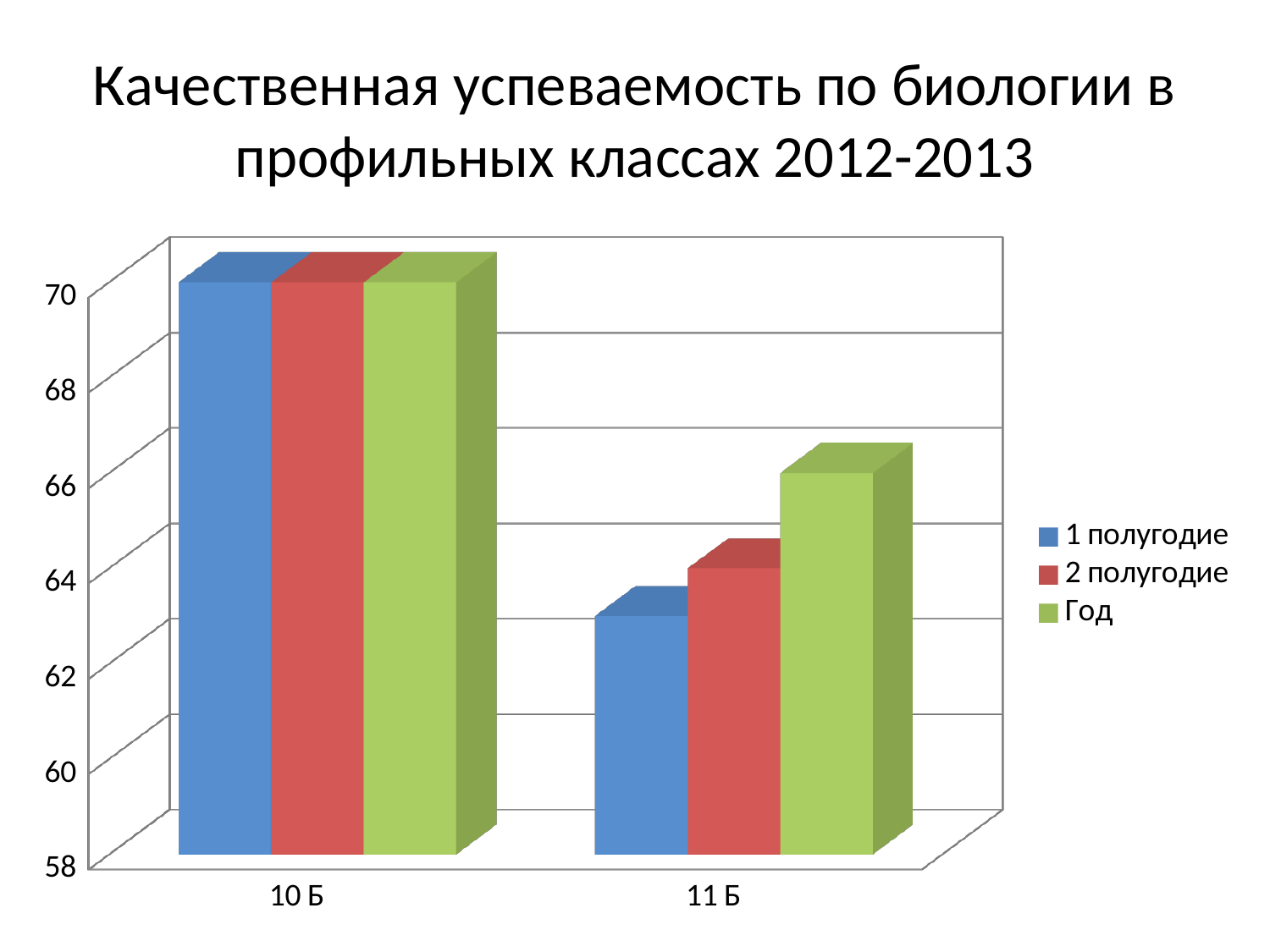
Which series has the lowest value for 11 Б? 1 полугодие What are the series names listed in the chart legend? 1 полугодие, 2 полугодие, Год How many series does the chart legend list? 3 Is the value for 1 полугодие in 11 Б greater or less than 64? less Is the value for Год in 11 Б greater or less than 64? greater Is the value for 2 полугодие in 11 Б greater or less than 62? greater What is the title of the chart on the slide? Качественная успеваемость по биологии в профильных классах 2012-2013 How many categories are shown on the x axis of the chart? 2 Which class has the larger value for Год, 10 Б or 11 Б? 10 Б Which series has the highest value for 11 Б? Год What kind of chart is shown on the slide? Bar chart